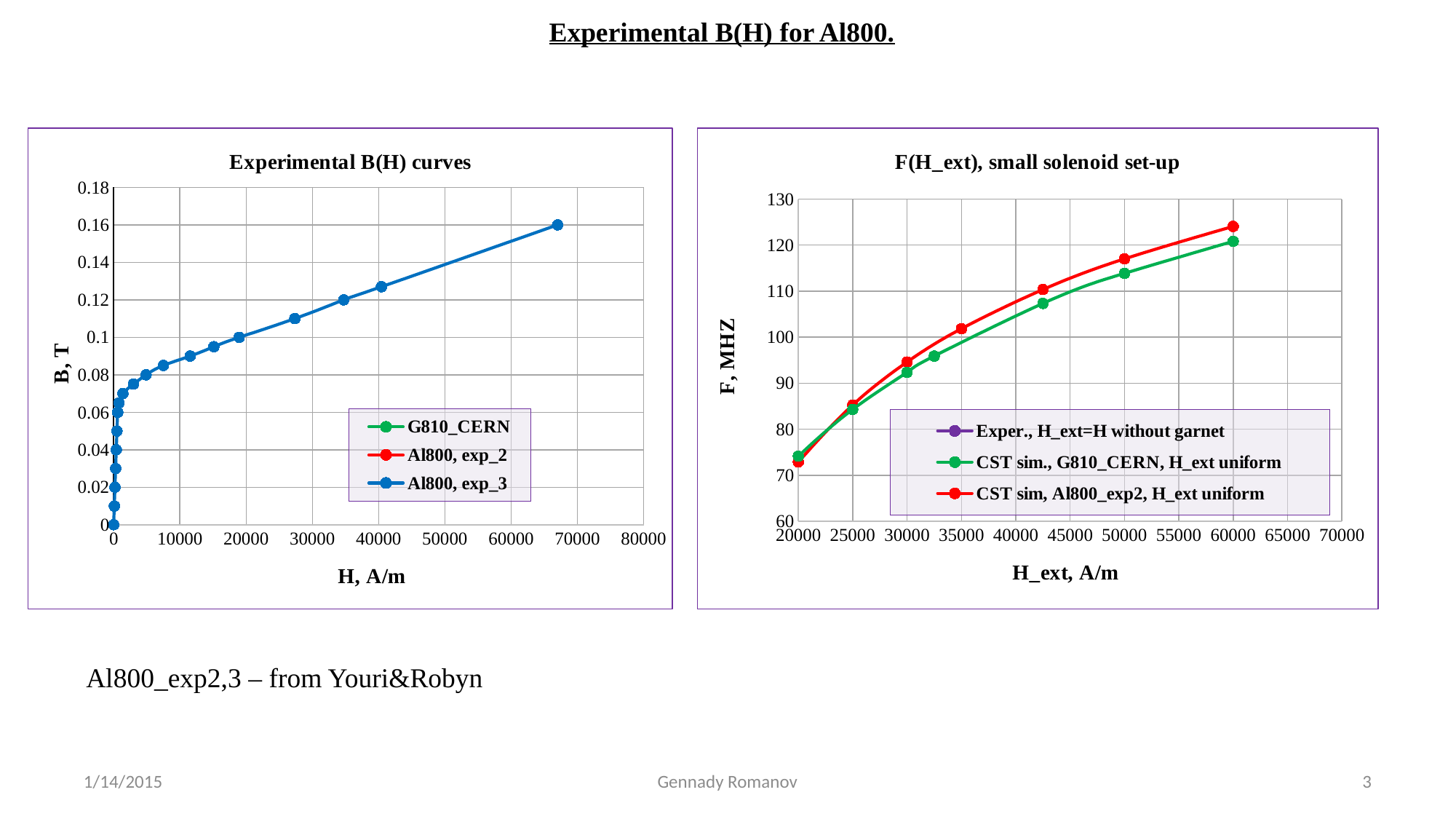
How many series does the legend of the right chart 'F(H_ext), small solenoid set-up' list? 3 In the left chart 'Experimental B(H) curves', what is the label of the x axis? H, A/m In the right chart 'F(H_ext), small solenoid set-up', does F rise or fall as H_ext increases? rise In the left chart 'Experimental B(H) curves', is the B value of the rightmost plotted point (near H = 67000) greater or less than 0.14? greater In the right chart 'F(H_ext), small solenoid set-up', is the value of 'CST sim., G810_CERN, H_ext uniform' at H_ext = 20000 greater or less than 80? less How many series does the legend of the left chart 'Experimental B(H) curves' list? 3 In the left chart 'Experimental B(H) curves', does B rise or fall as H increases? rise In the right chart 'F(H_ext), small solenoid set-up', at H_ext = 60000, which series is higher: 'CST sim, Al800_exp2, H_ext uniform' or 'CST sim., G810_CERN, H_ext uniform'? CST sim, Al800_exp2, H_ext uniform What type of chart is the left chart titled 'Experimental B(H) curves'? line chart What is the title of the right chart? F(H_ext), small solenoid set-up In the right chart 'F(H_ext), small solenoid set-up', is the value of 'CST sim, Al800_exp2, H_ext uniform' at H_ext = 60000 greater or less than 120? greater